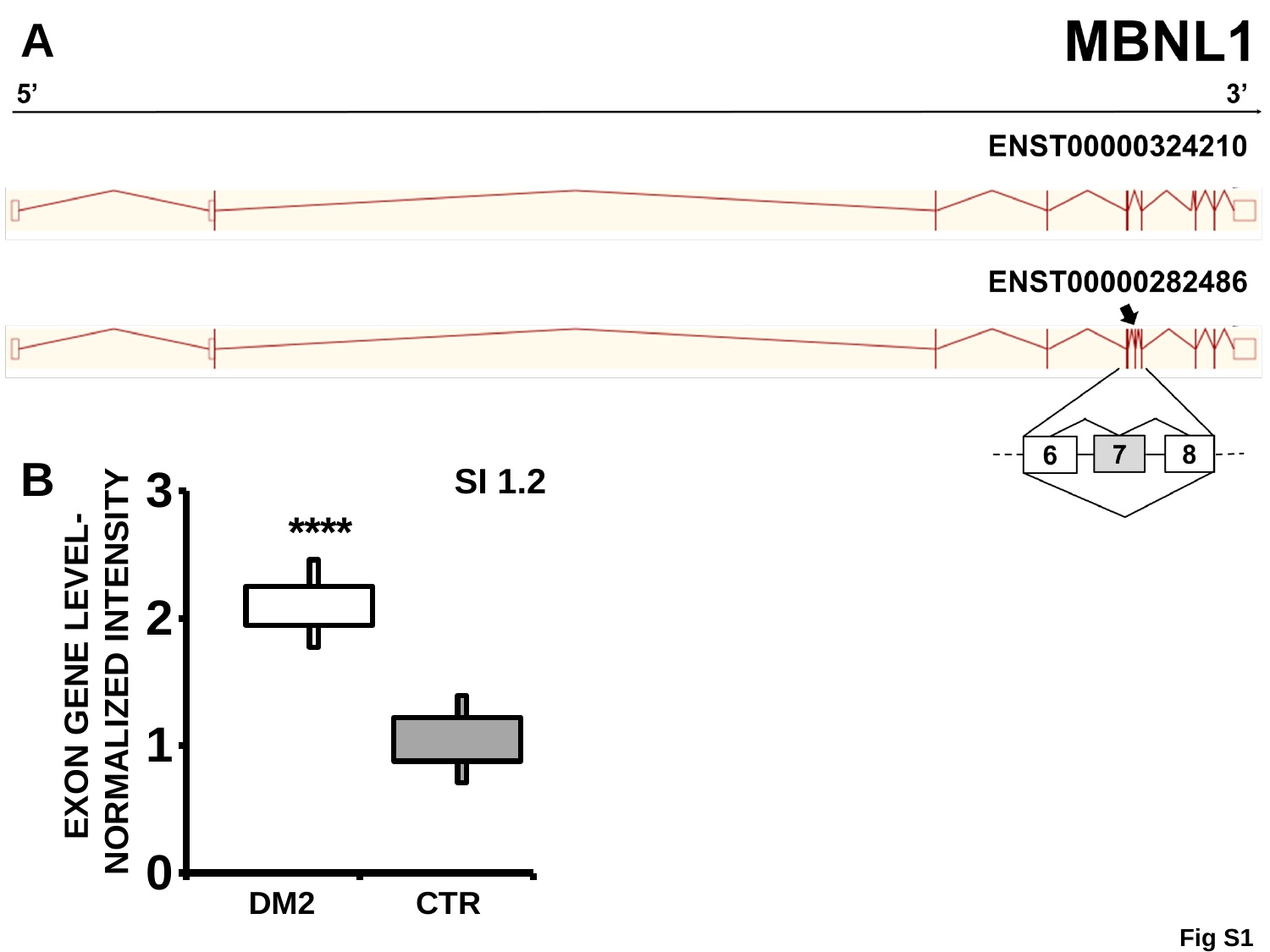
In panel B, which group shows the lowest normalized intensity? CTR In panel B, what annotation is printed above the chart near the top right? SI 1.2 In panel B, is the value for DM2 greater or less than 1? greater In panel B, is the value for CTR greater or less than 2? less In panel B, what kind of chart is shown? box plot In panel B, which group has the higher normalized intensity, DM2 or CTR? DM2 In panel B, how many groups are plotted on the x axis? 2 In panel B, which group shows the highest normalized intensity? DM2 In panel B, which group is marked with asterisks (****)? DM2 In panel B, what is the maximum value shown on the y axis? 3